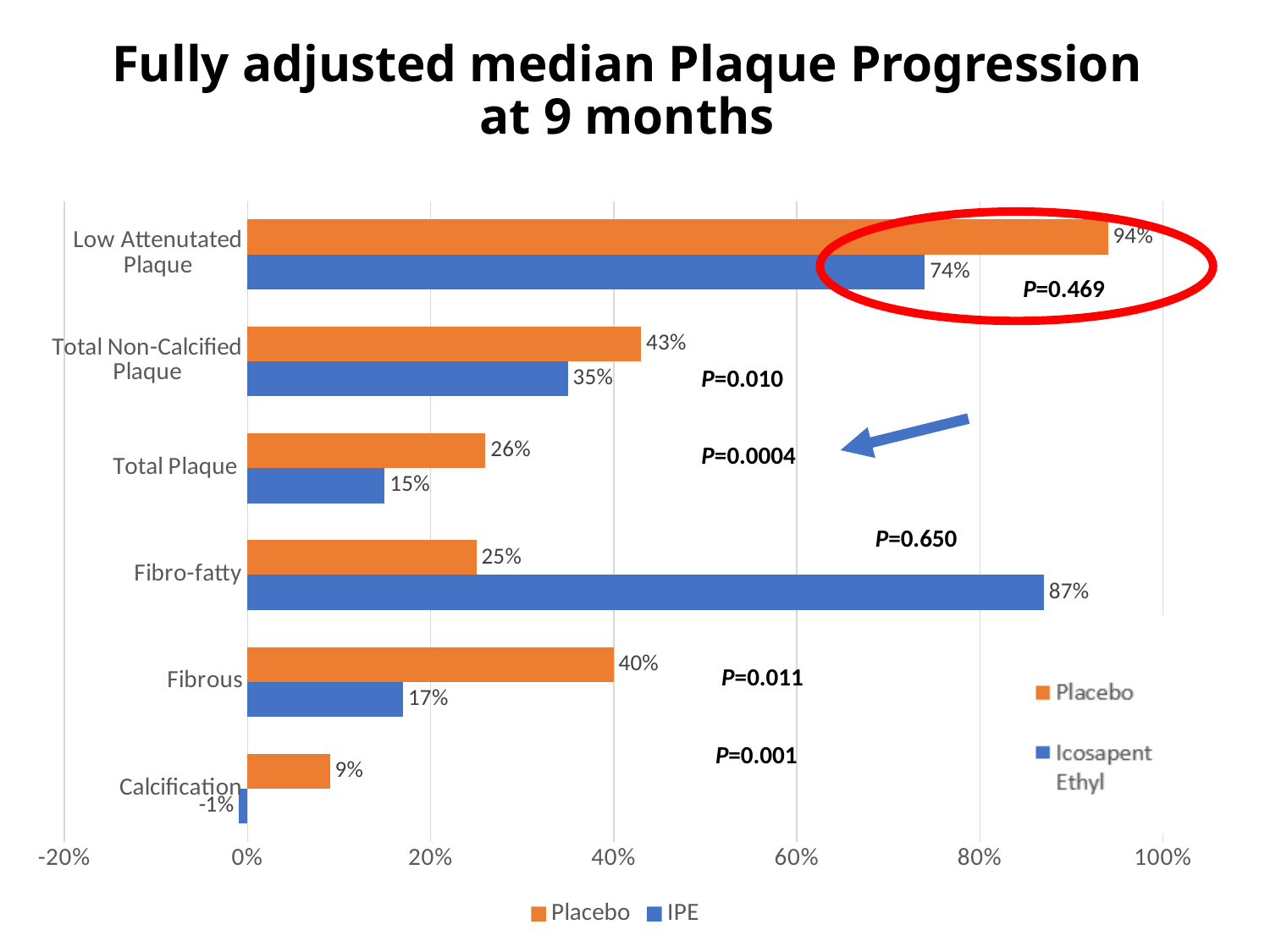
Which is larger for Fibro-fatty, the Placebo value or the IPE value? IPE What is the Placebo value for Low Attenuated Plaque? 94% What is the IPE value for Calcification? -1% What P value is shown next to the Total Plaque bars? P=0.0004 What is the Placebo value for Fibrous? 40% Which category has the highest Placebo value? Low Attenuated Plaque What is the difference between the Placebo and IPE values for Total Plaque? 11% What is the IPE value for Fibro-fatty? 87% What kind of chart is shown on the slide? Bar chart How many series does the legend at the bottom of the chart list? 2 How many plaque categories are shown on the chart? 6 Which category has the lowest IPE value? Calcification